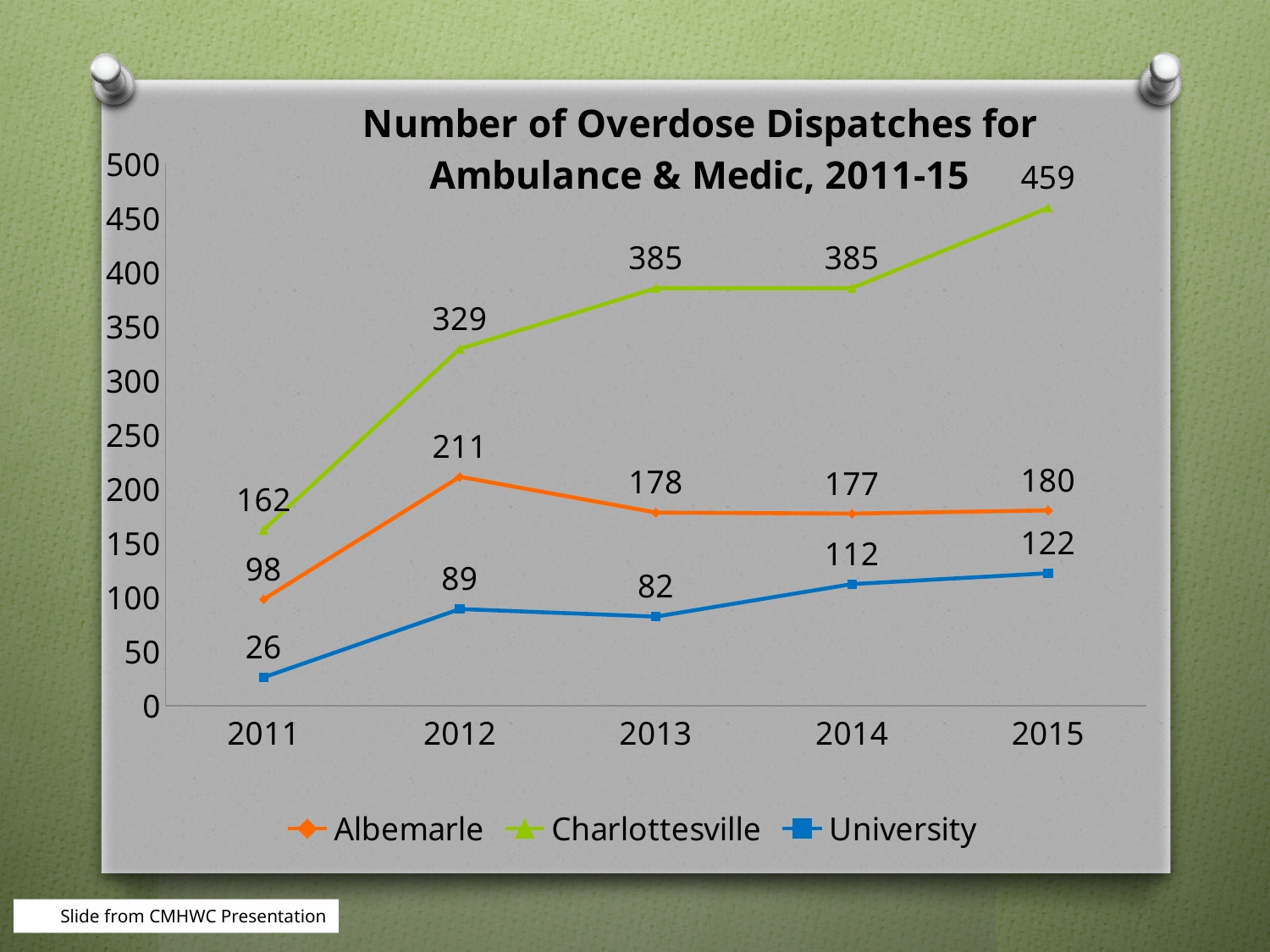
Which is larger in 2013: Albemarle or University? Albemarle In which year is the Charlottesville series highest? 2015 What is the difference between Charlottesville and Albemarle in 2015? 279 How many years are shown on the x axis? 5 What is the title of the chart? Number of Overdose Dispatches for Ambulance & Medic, 2011-15 How many series does the legend list? 3 What kind of chart is this? Line chart In which year is the University series lowest? 2011 Does the University series rise or fall from 2013 to 2015? Rise What is the value for Charlottesville in 2015? 459 What is the value for Albemarle in 2012? 211 What is the value for University in 2011? 26